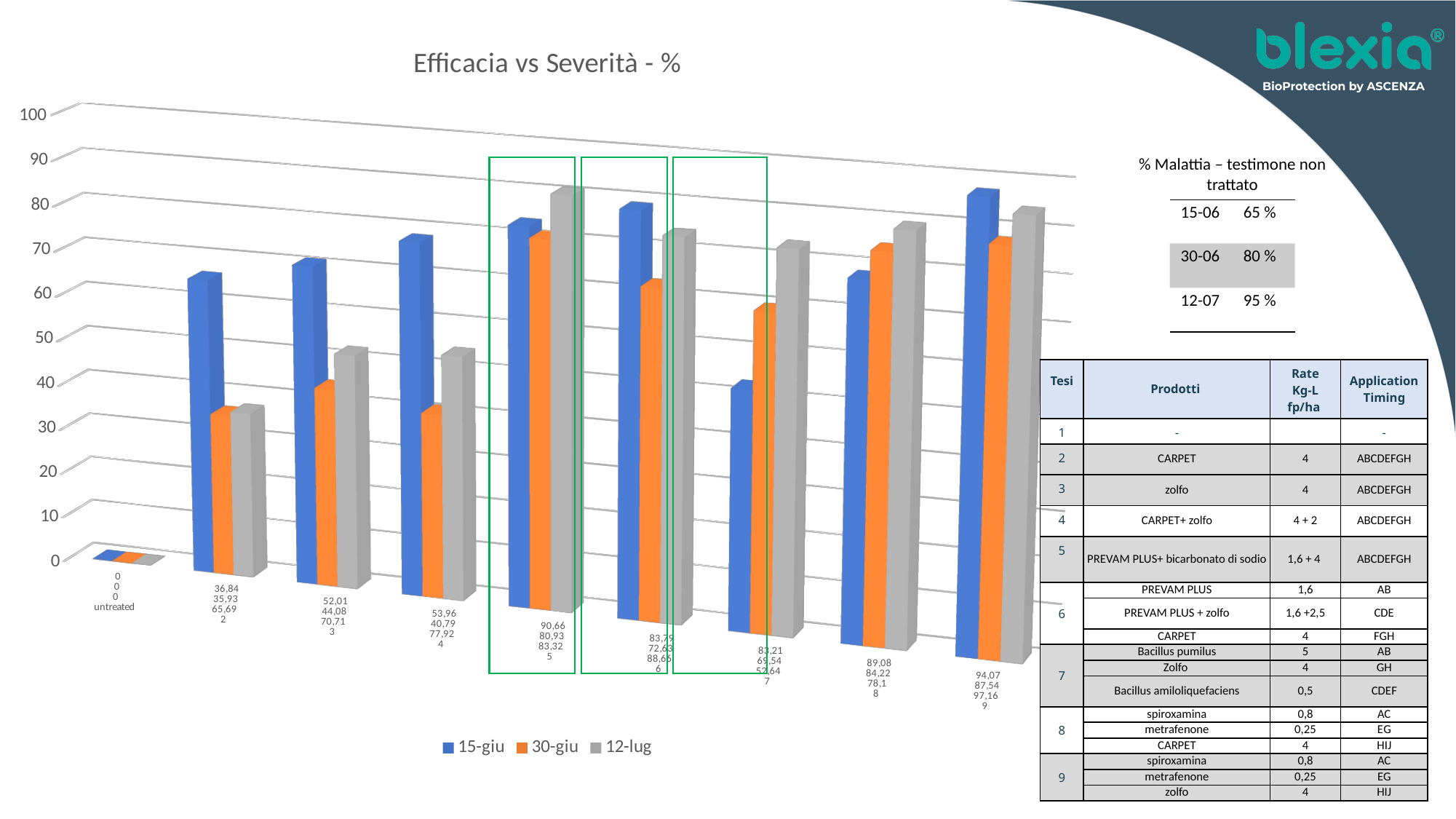
What kind of chart is shown on the slide? bar chart What is the highest value printed anywhere on the chart? 97,16 What is the title of the chart? Efficacia vs Severità - % How many series does the chart legend list? 3 Which category has the highest printed value on the chart? 9 What three values are printed for category 9? 94,07, 87,54, 97,16 What are the three series named in the chart legend? 15-giu, 30-giu, 12-lug What three values are printed for category 8? 89,08, 84,22, 78,1 What values are printed for the untreated category? 0, 0, 0 What is the lowest non-zero value printed on the chart? 35,93 How many categories (groups of bars) are plotted on the x axis of the chart? 9 What is the largest of the three values printed for category 5? 90,66